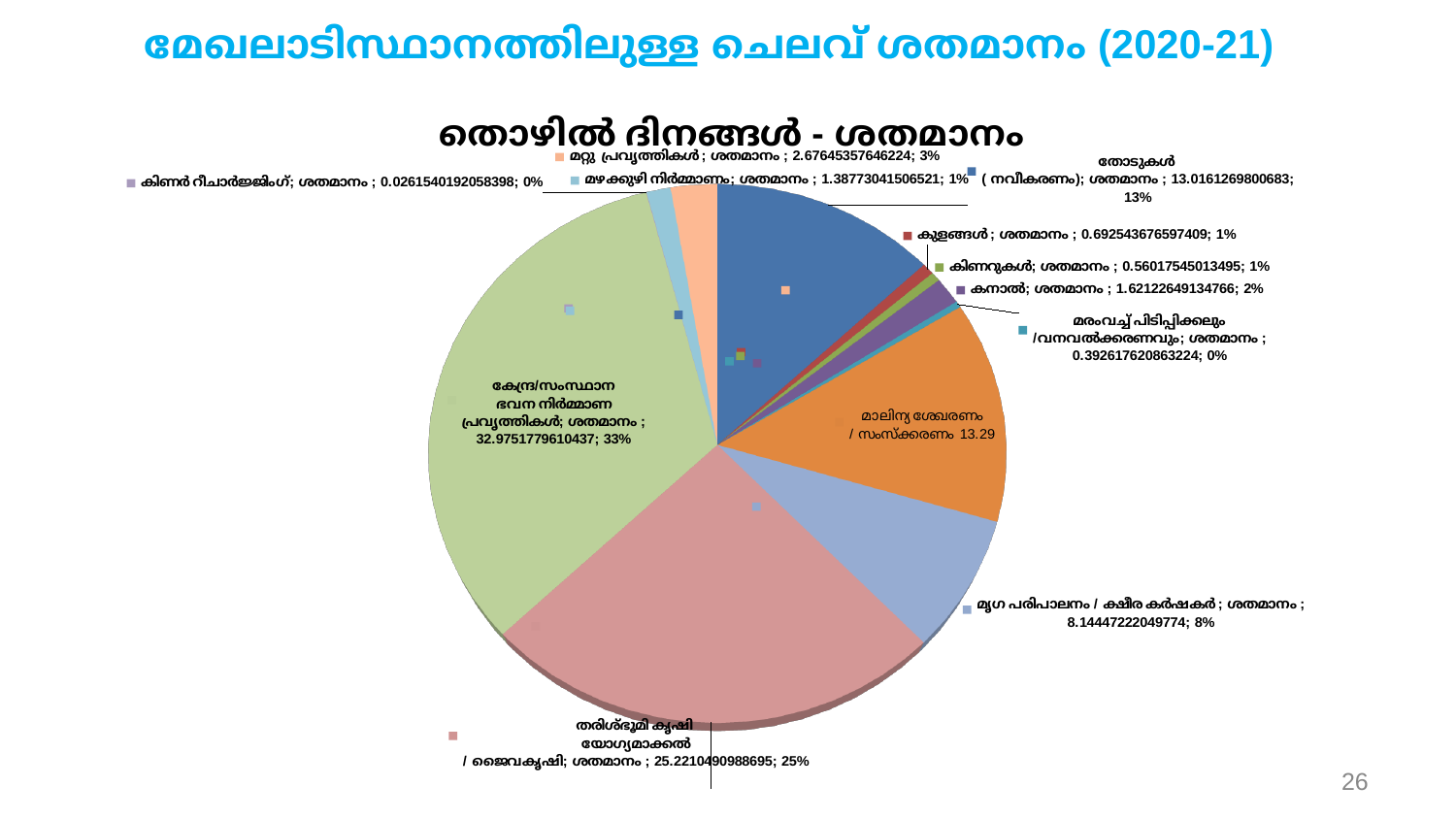
Which category has the smallest share of the pie? കിണർ റീചാർജ്ജിംഗ് How many slices does the pie chart have? 12 What kind of chart is shown on the slide? Pie chart Which category has the largest share of the pie? കേന്ദ്ര/സംസ്ഥാന ഭവന നിർമ്മാണ പ്രവൃത്തികൾ What value is printed for മാലിന്യ ശേഖരണം / സംസ്കരണം? 13.29 Which has a larger share: കനാൽ or കുളങ്ങൾ? കനാൽ What is the title of the chart? തൊഴിൽ ദിനങ്ങൾ - ശതമാനം What percentage share is shown for മൃഗ പരിപാലനം / ക്ഷീര കർഷകർ? 8% What percentage share is shown for കേന്ദ്ര/സംസ്ഥാന ഭവന നിർമ്മാണ പ്രവൃത്തികൾ? 33% What percentage share is shown for തരിശ്ഭൂമി കൃഷി യോഗ്യമാക്കൽ / ജൈവകൃഷി? 25% What is the difference in percentage points between the shares of കേന്ദ്ര/സംസ്ഥാന ഭവന നിർമ്മാണ പ്രവൃത്തികൾ (33%) and തരിശ്ഭൂമി കൃഷി യോഗ്യമാക്കൽ / ജൈവകൃഷി (25%)? 8%